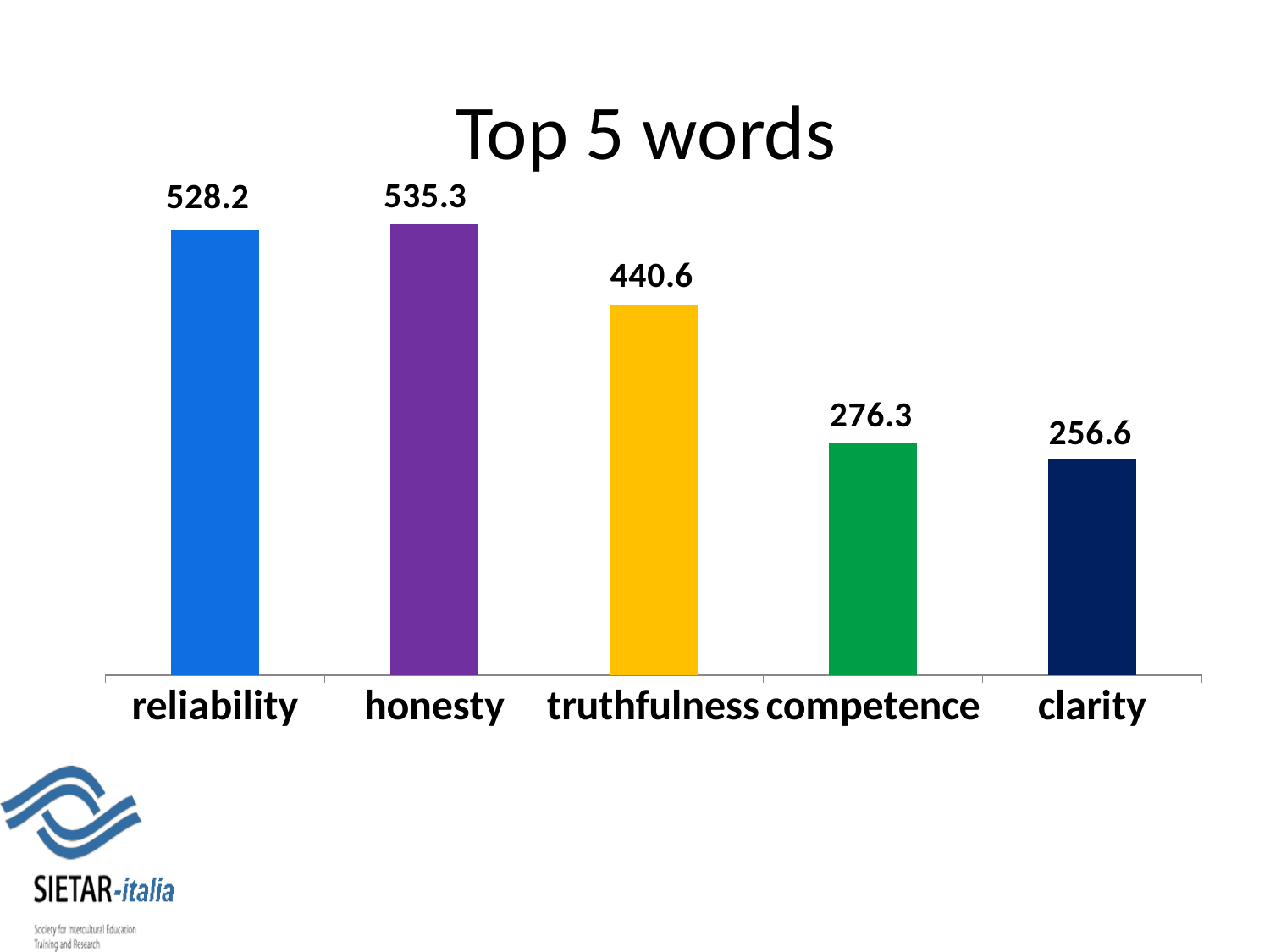
What is the value for reliability? 528.2 What is the value for clarity? 256.6 What is the difference between the values for truthfulness and competence? 164.3 What is the difference between the values for honesty and reliability? 7.1 How many words are shown in the chart? 5 Which word has the highest value? honesty What is the value for honesty? 535.3 What is the value for competence? 276.3 What type of chart is shown on the slide? bar chart Which has a larger value, competence or clarity? competence What is the value for truthfulness? 440.6 Which word has the lowest value? clarity